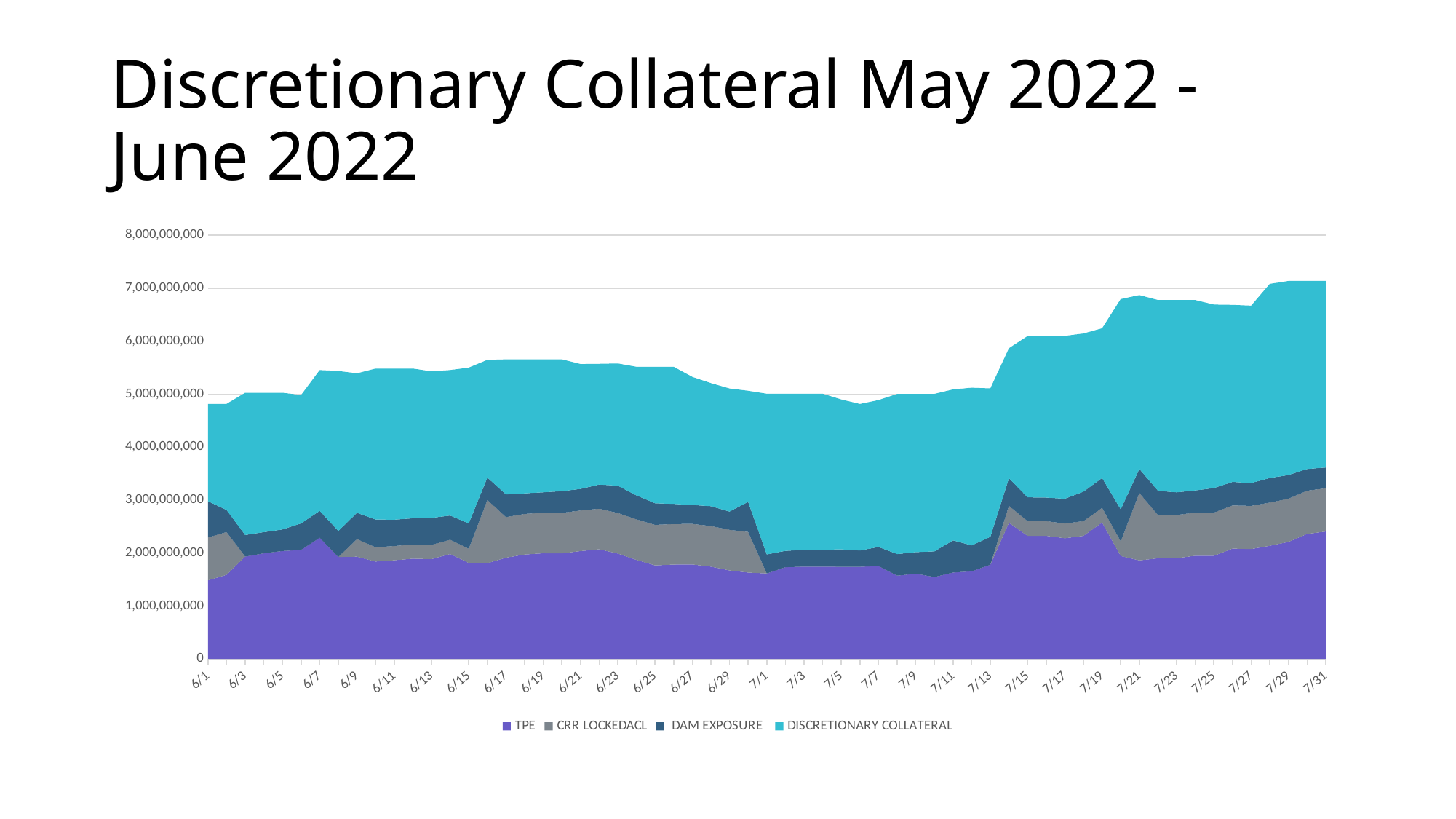
On 7/31, which band is larger: DISCRETIONARY COLLATERAL or TPE? DISCRETIONARY COLLATERAL What is the title of the chart on the slide? Discretionary Collateral May 2022 - June 2022 Which series occupies the largest band of the stack across the chart? DISCRETIONARY COLLATERAL How many series does the legend list? 4 What type of chart is shown on the slide? Stacked area chart Is the TPE value on 6/1 greater or less than 2,000,000,000? less Is the TPE value on 7/15 greater or less than 2,000,000,000? greater Does the total stacked value rise or fall between 7/13 and 7/31? rise Is the total stacked value on 7/31 greater or less than 6,000,000,000? greater Which series is shown in the light teal colour at the top of the stack? DISCRETIONARY COLLATERAL